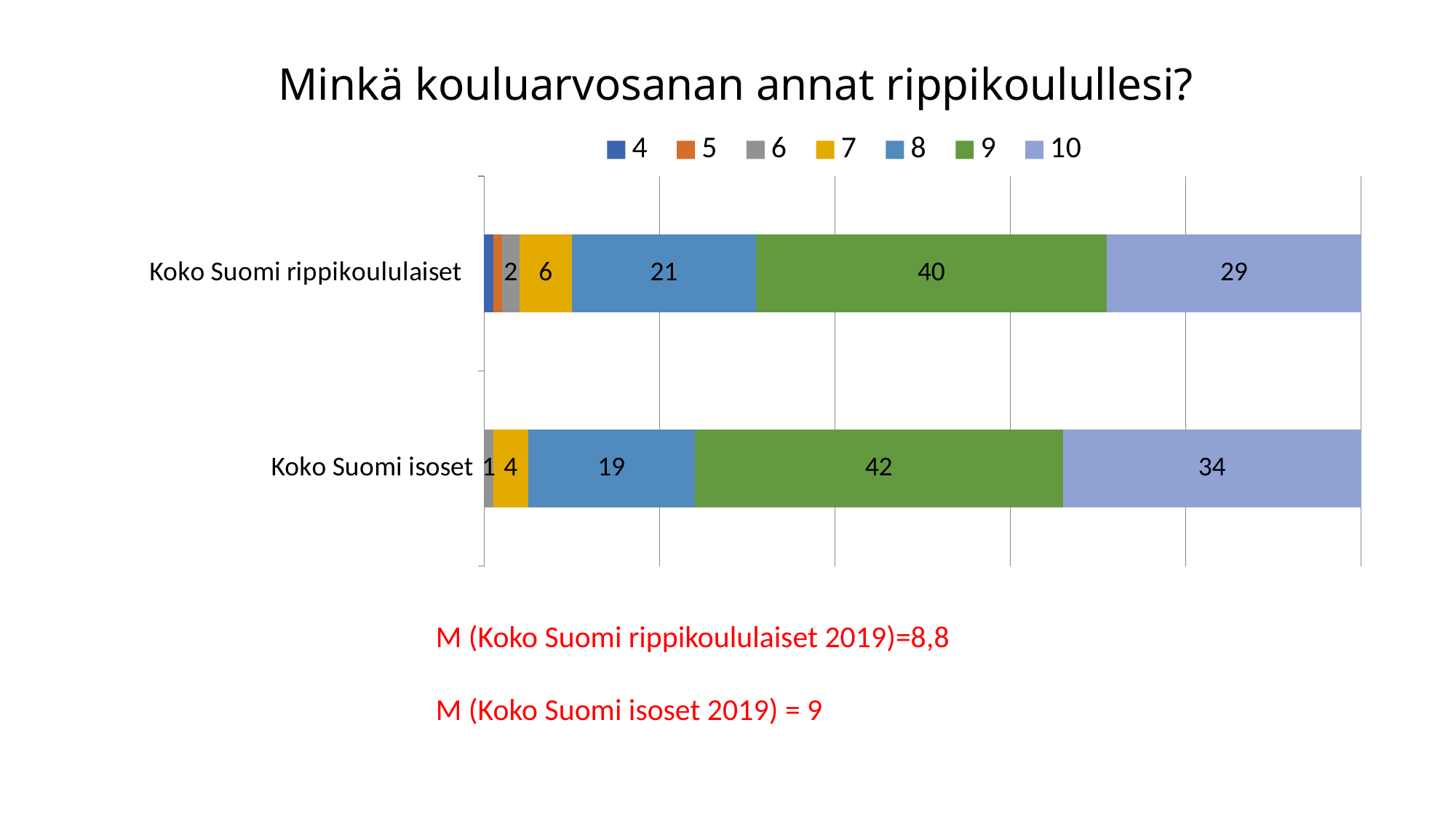
What is the value for grade 10 in the Koko Suomi isoset bar? 34 What is the total of the Koko Suomi isoset stacked bar? 100 What is the difference between the grade 10 values for Koko Suomi isoset and Koko Suomi rippikoululaiset? 5 What is the value for grade 8 in the Koko Suomi rippikoululaiset bar? 21 What kind of chart is shown on the slide? Stacked bar chart Which group has the larger value for grade 9, Koko Suomi isoset or Koko Suomi rippikoululaiset? Koko Suomi isoset What is the value for grade 9 in the Koko Suomi rippikoululaiset bar? 40 How many series does the legend list? 7 Which labelled grade has the smallest segment in the Koko Suomi isoset bar? 6 How many categories (bars) are shown in the chart? 2 Which grade has the largest segment in the Koko Suomi rippikoululaiset bar? 9 What is the value for grade 7 in the Koko Suomi isoset bar? 4